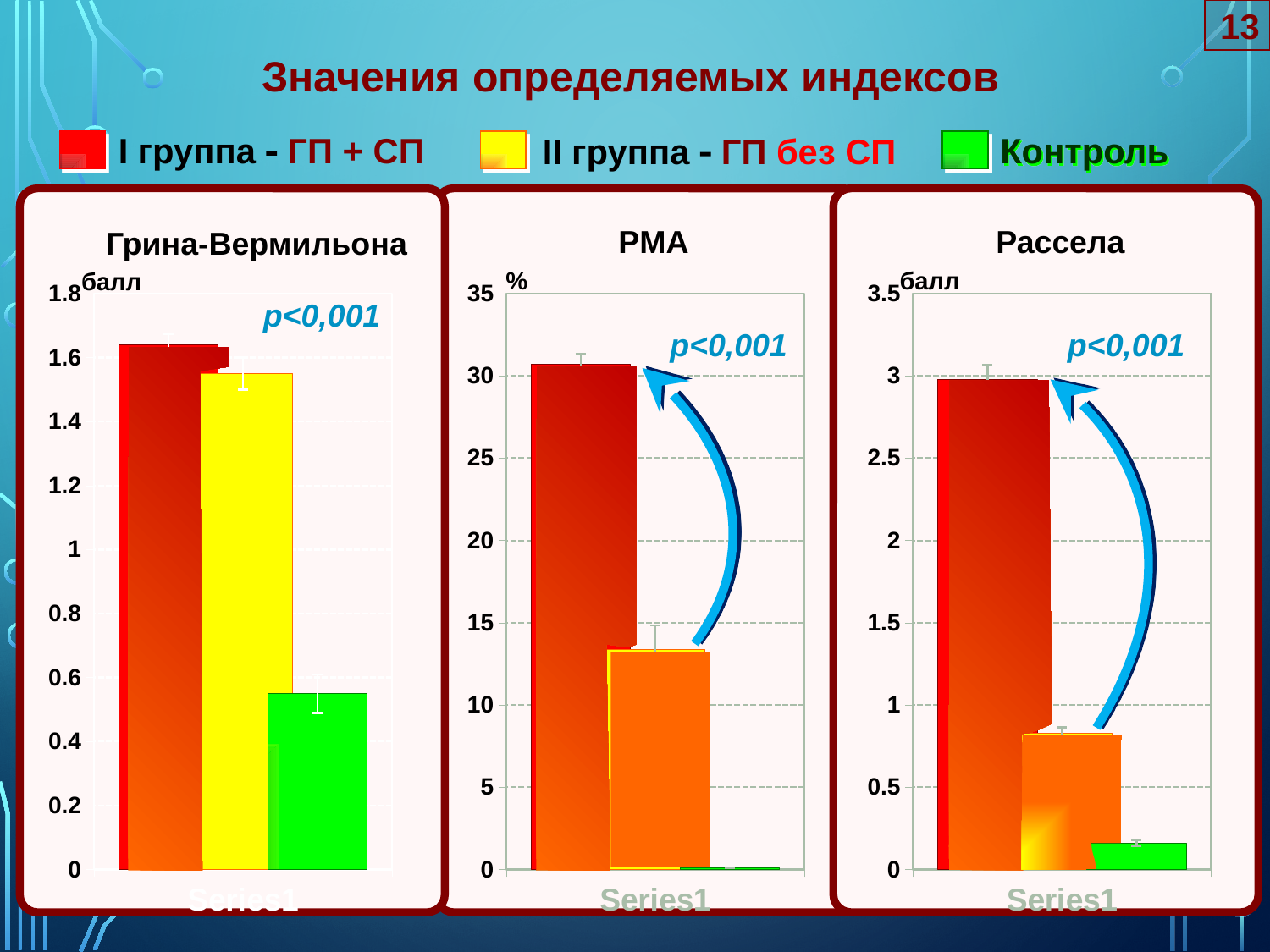
In the РМА chart, is the value for I группа - ГП + СП greater or less than 25? greater In the РМА chart, is the value for II группа - ГП без СП greater or less than 15? less In the Рассела chart, which group has the lowest value? Контроль In the Грина-Вермильона chart, is the value for Контроль greater or less than 0.4? greater In the Рассела chart, which is larger: the value for II группа - ГП без СП or the value for Контроль? II группа - ГП без СП In the РМА chart, which group has the highest value? I группа - ГП + СП In the Грина-Вермильона chart, which group has the lowest value? Контроль What unit is shown on the vertical axis of the РМА chart? % What kind of chart is the Грина-Вермильона chart? bar chart How many bars are shown in the РМА chart? 3